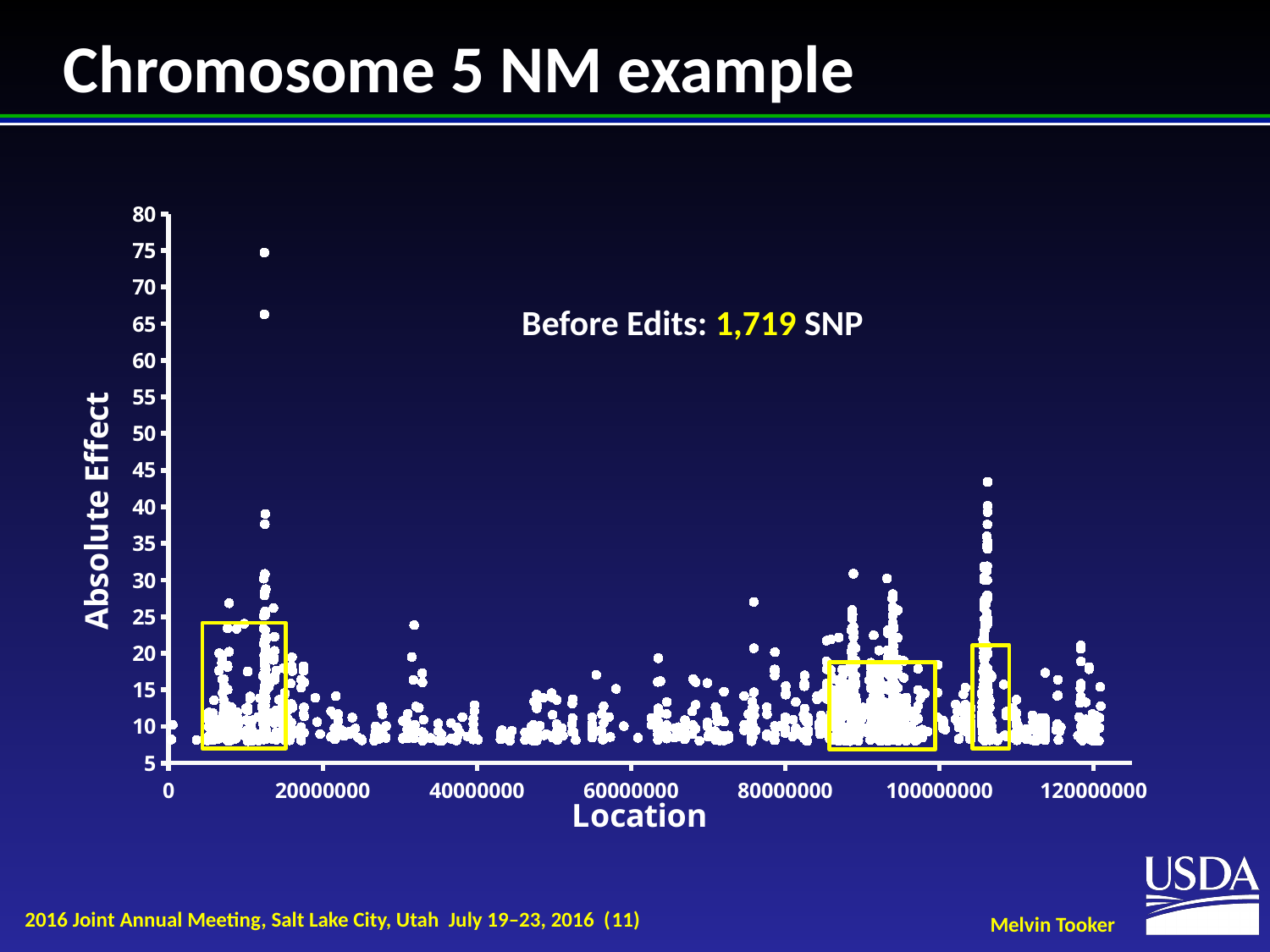
What is the lowest tick value shown on the Absolute Effect axis? 5 What is the label of the y axis of the chart? Absolute Effect How many yellow rectangles are drawn on the chart to highlight regions? 3 What is the highest tick value shown on the Location axis? 120000000 Is the highest point on the chart located at a Location less or greater than 20000000? less Is the highest point located near 90000000 on the Location axis greater or less than 40 on the Absolute Effect axis? less Is the highest point on the chart greater or less than 70 on the Absolute Effect axis? greater What is the highest tick value shown on the Absolute Effect axis? 80 What kind of chart is shown on the slide? scatter plot What is the label of the x axis of the chart? Location According to the annotation on the chart, how many SNP are there before edits? 1,719